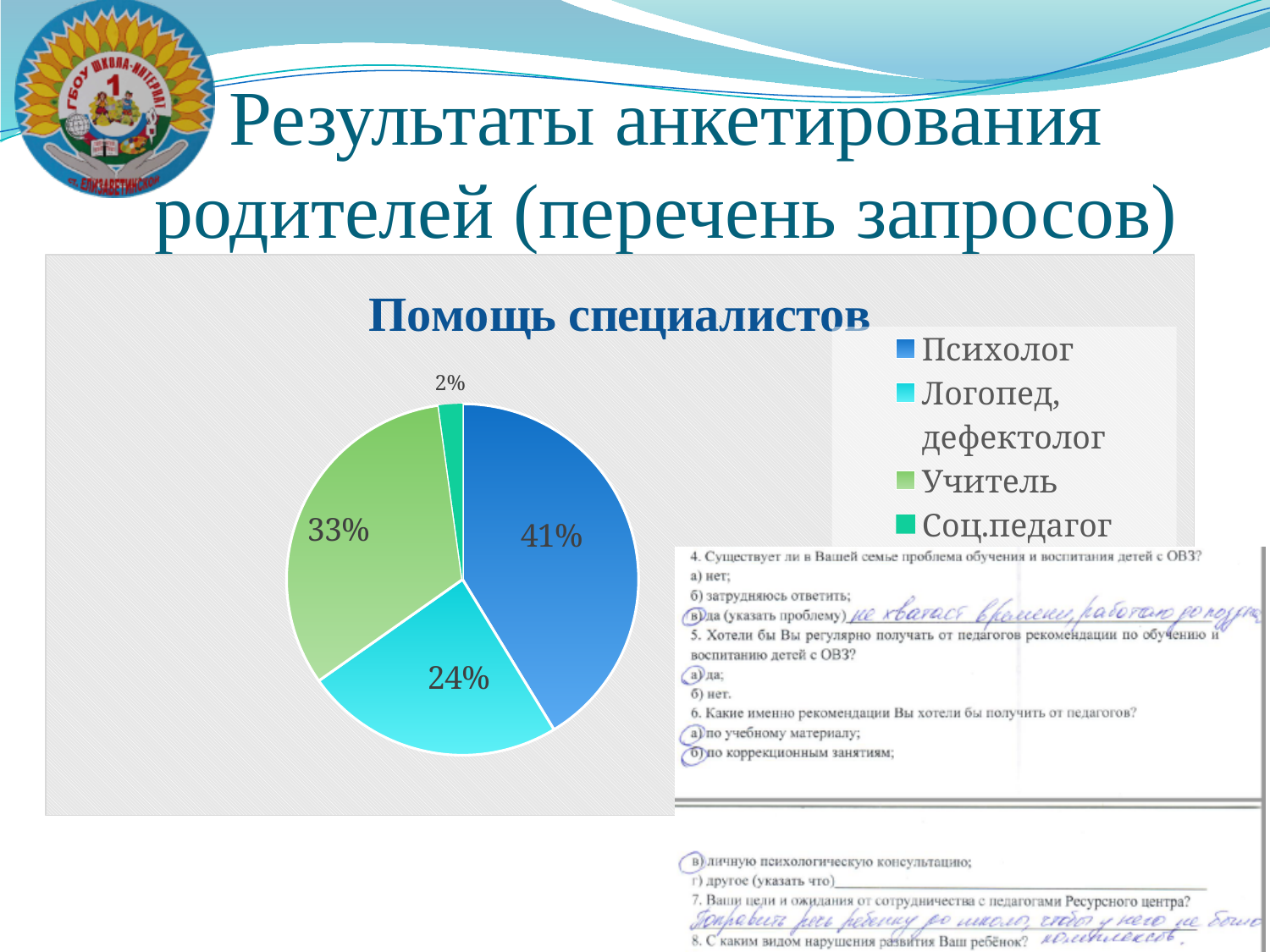
Which category has the largest slice of the pie? Психолог What share of the pie does Логопед, дефектолог have? 24% What kind of chart is shown on the slide? pie chart Which is larger, the share for Учитель or the share for Логопед, дефектолог? Учитель What share of the pie does Психолог have? 41% Which category has the smallest slice of the pie? Соц.педагог What colour is the slice for Психолог? blue How many categories does the legend list? 4 What is the difference in percentage points between Психолог and Учитель? 8 What is the title of the chart? Помощь специалистов What share of the pie does Учитель have? 33% What share of the pie does Соц.педагог have? 2%